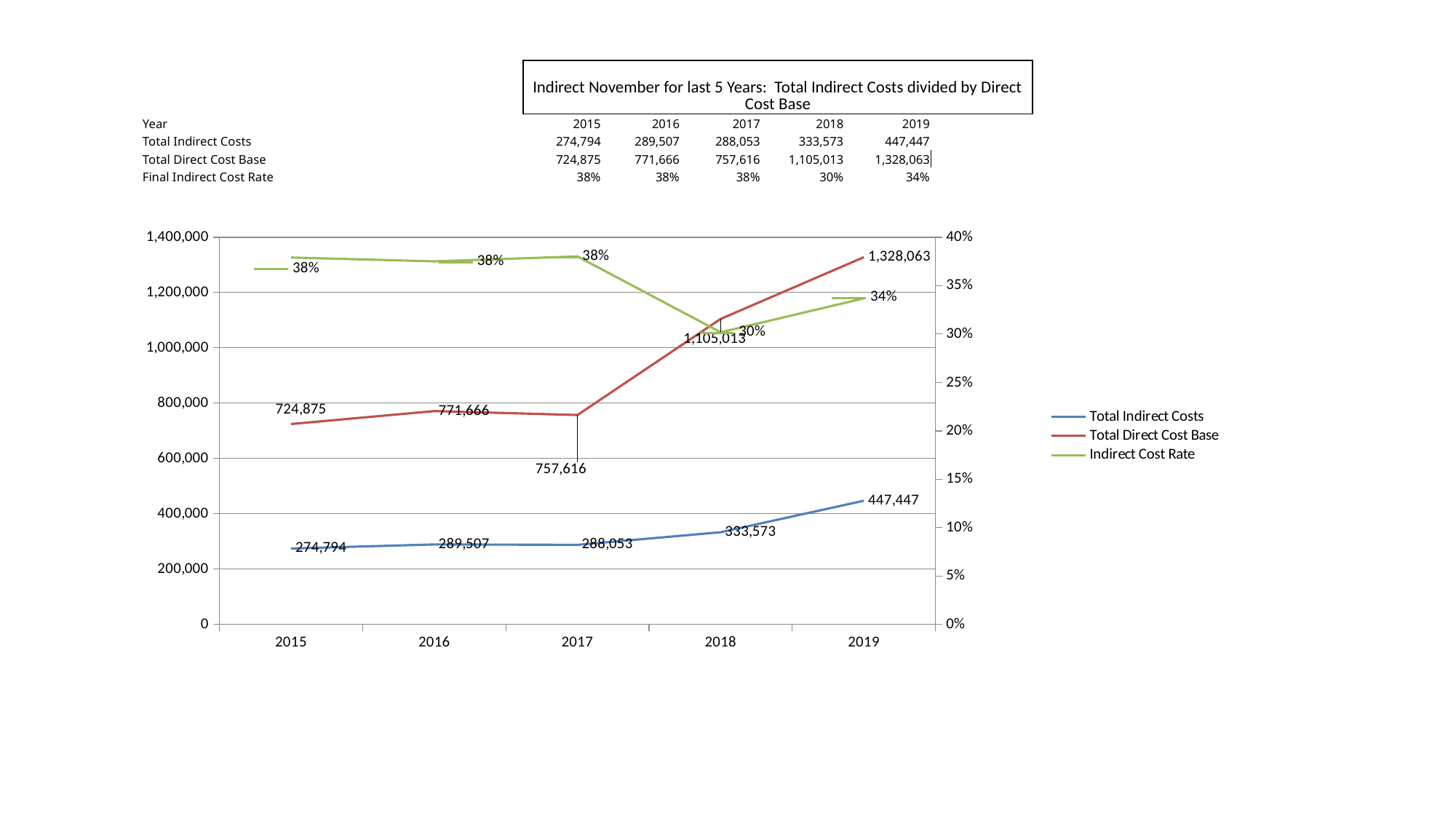
Does Total Direct Cost Base rise or fall from 2017 to 2019? Rise What kind of chart is shown? Line chart Which is larger: Total Direct Cost Base in 2016 or in 2017? 2016 What is the difference between Total Direct Cost Base in 2019 and 2018? 223,050 What is the Total Direct Cost Base for 2019? 1,328,063 In which year is Total Indirect Costs highest? 2019 In which year is the Indirect Cost Rate lowest? 2018 What is the Indirect Cost Rate for 2018? 30% What is the difference between Total Indirect Costs in 2019 and 2018? 113,874 How many series does the legend list? 3 How many years are plotted on the x axis? 5 What is the Total Indirect Costs value for 2017? 288,053